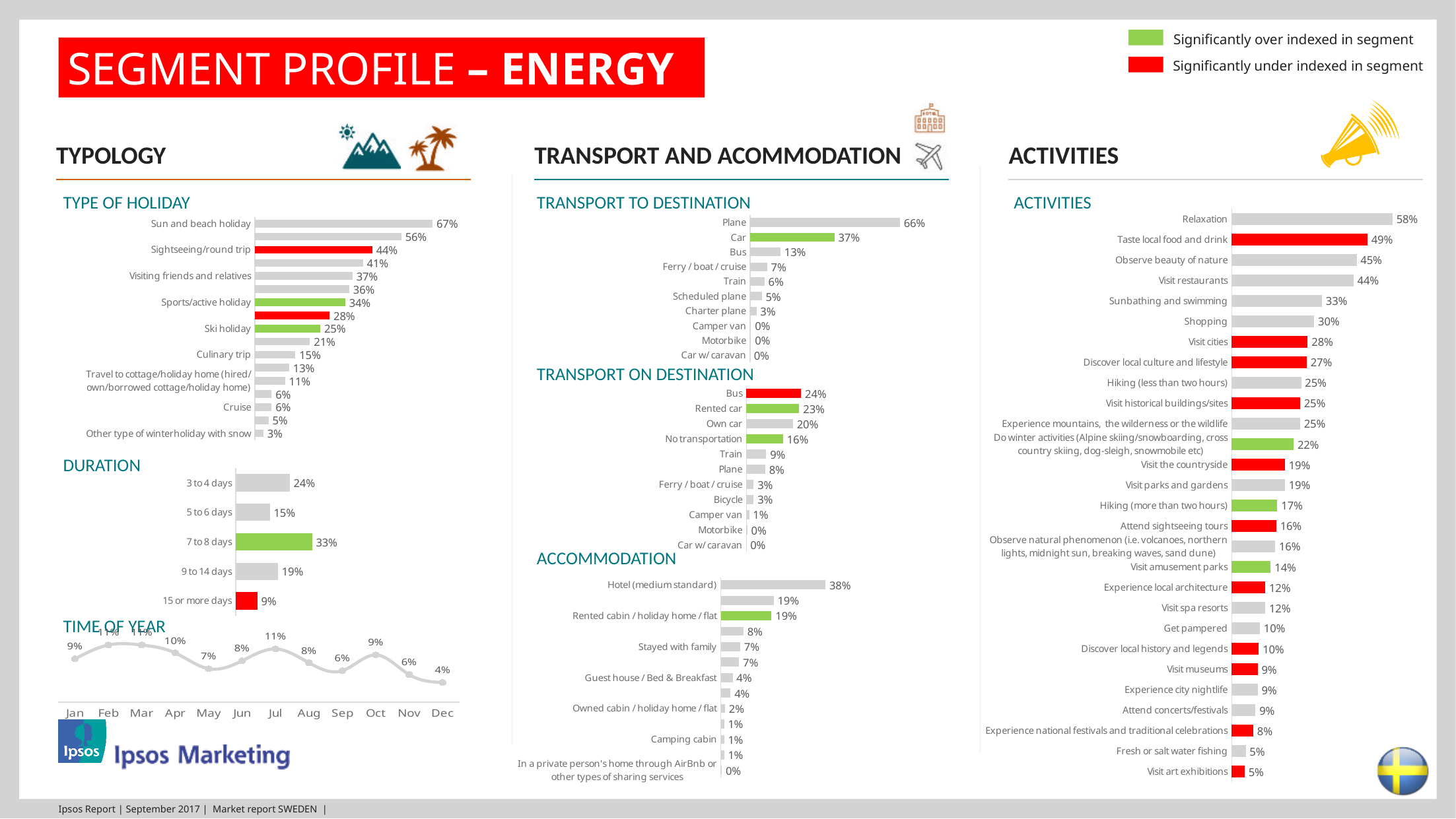
In the Activities chart, which is larger, Visit cities or Shopping? Shopping In the Accommodation chart, what is the value for Hotel (medium standard)? 38% In the Activities chart, which activity has the highest value? Relaxation In the Transport on Destination chart, which category has the highest value? Bus In the Activities chart, what is the value for Taste local food and drink? 49% In the Time of Year chart, which month has the lowest value? Dec In the Duration chart, which category has the highest value? 7 to 8 days In the Type of Holiday chart, what is the value for Sun and beach holiday? 67% In the Duration chart, how many categories are shown? 5 In the Transport to Destination chart, what is the difference between Plane and Car? 29 percentage points In the Transport to Destination chart, what is the value for Car? 37% In the Duration chart, what is the value for 15 or more days? 9%